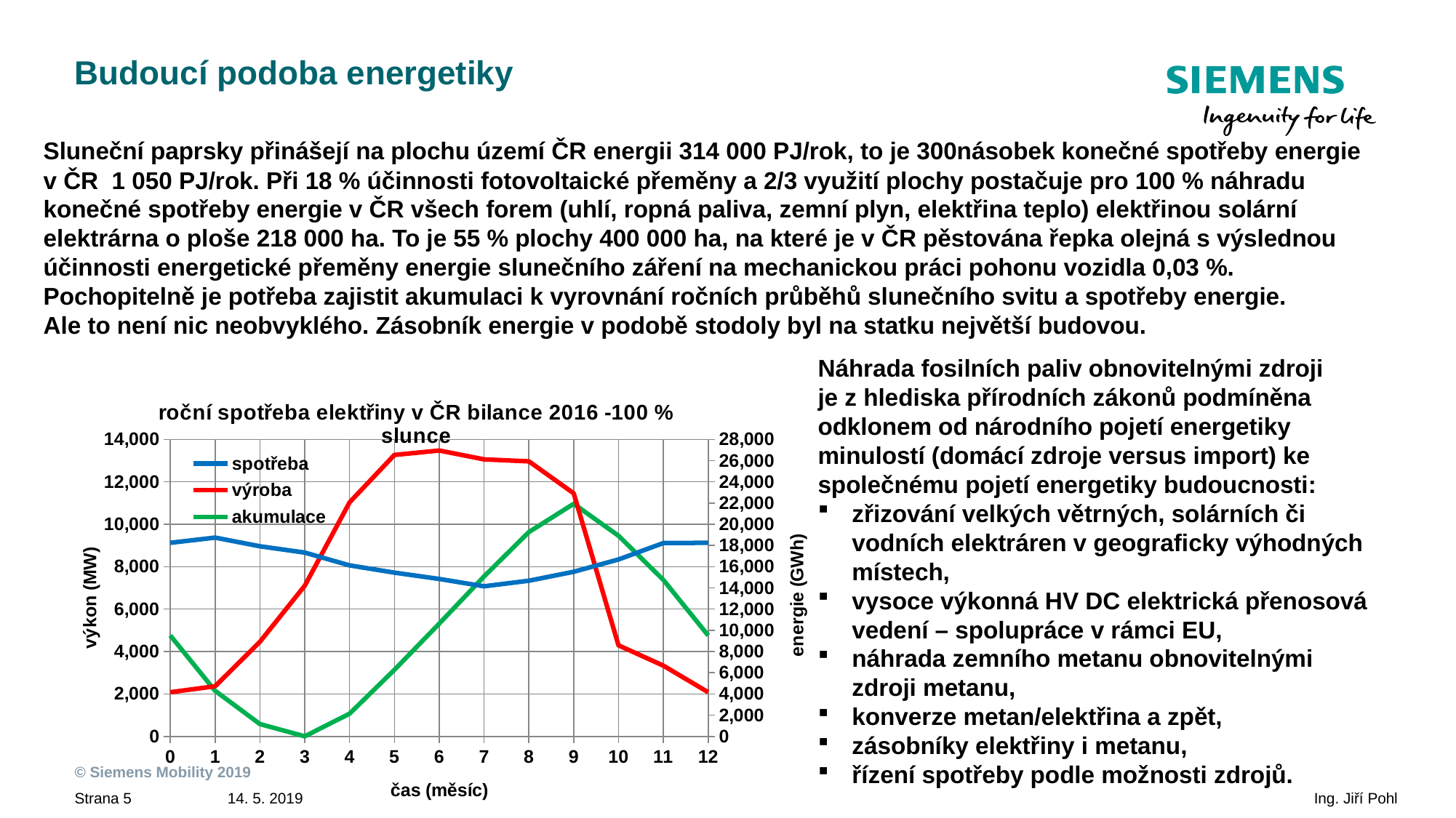
How many month points are plotted along the x axis (from 0 to 12)? 13 What are the three series named in the chart legend? spotřeba, výroba, akumulace Does the výroba series rise or fall between month 0 and month 6? rise What kind of chart is shown on the slide? line chart In which month does the spotřeba series reach its lowest value? 7 In which month does the výroba series reach its highest value? 6 How many series does the chart legend list? 3 In which month does the akumulace series reach its highest value? 9 At month 0, which series has the larger value, spotřeba or výroba? spotřeba In which month does the akumulace series reach its lowest value? 3 What is the label of the x axis of the chart? čas (měsíc) Is the value of výroba at month 6 greater or less than 12,000 MW? greater